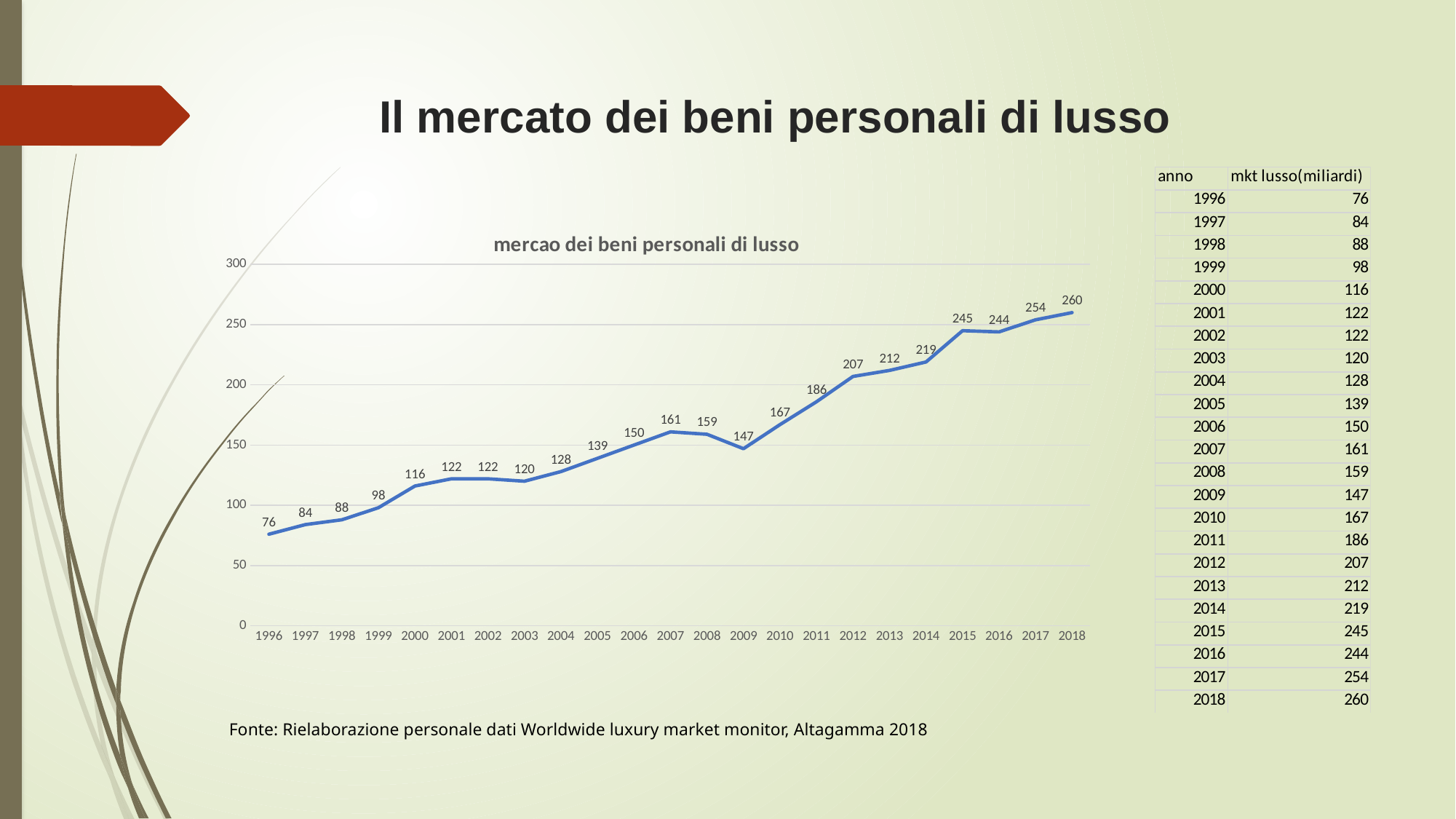
What is the value for 2009 in the chart? 147 What is the difference between the values for 2018 and 1996? 184 Which year has the lowest value in the chart? 1996 Overall, do the values rise or fall from 1996 to 2018? rise What is the title of the chart? mercao dei beni personali di lusso What is the value for 2000 in the chart? 116 What type of chart is shown on the slide? line chart Is the value for 2011 greater or less than 200? less Which year has the highest value in the chart? 2018 Which is larger, the value for 2007 or the value for 2008? 2007 What is the difference between the values for 2015 and 2016? 1 How many years are plotted on the x axis of the chart? 23